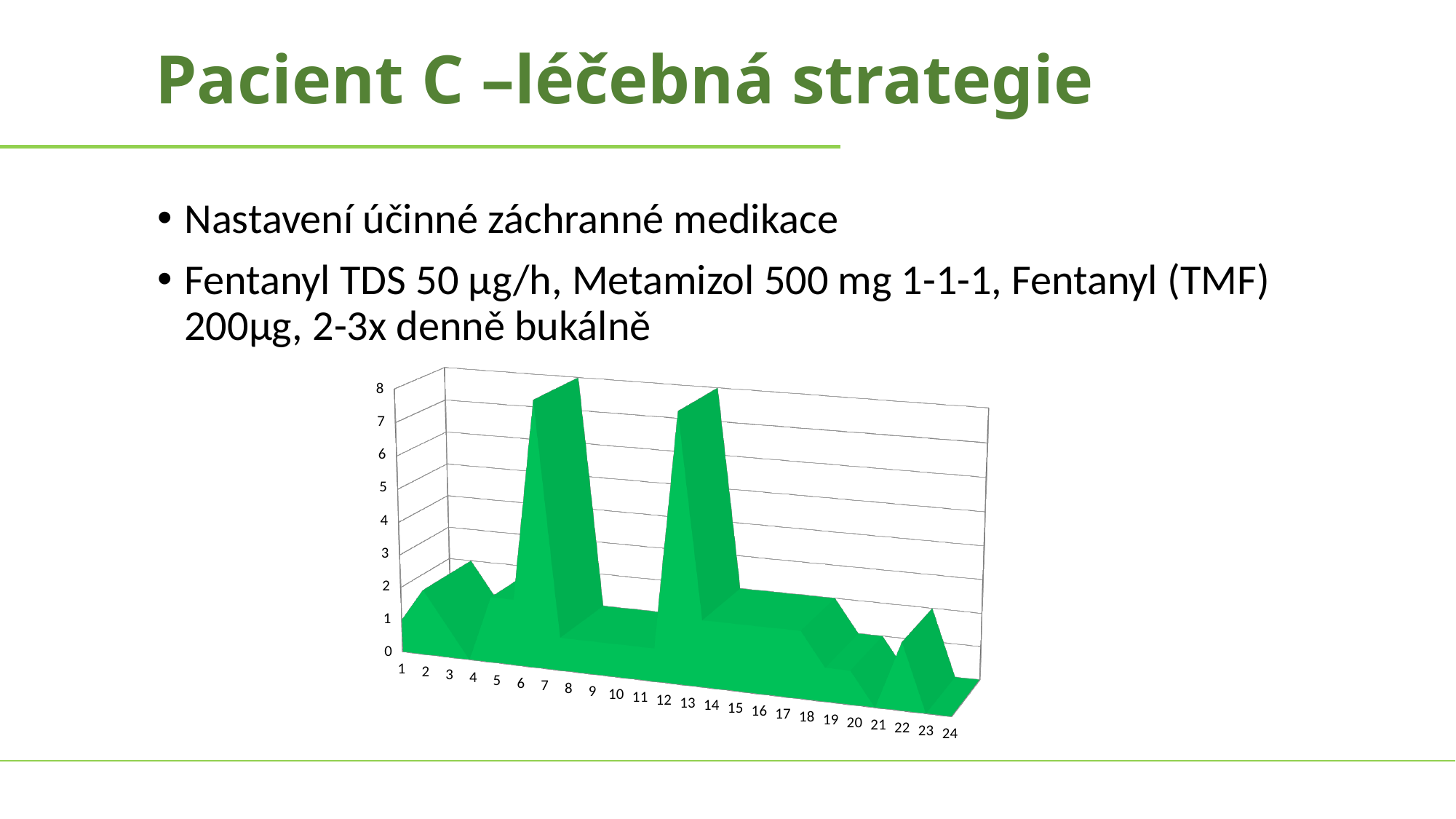
Which is larger, the value at point 13 or the value at point 20? point 13 Do the values rise or fall from point 11 to point 13? rise Is the value at point 13 greater or less than 6? greater Is the value at point 24 greater or less than 4? less Is the value at point 8 greater or less than 6? less How many points are plotted along the x axis of the chart? 24 What is the highest value shown on the vertical axis of the chart? 8 What kind of chart is shown on the slide? area chart